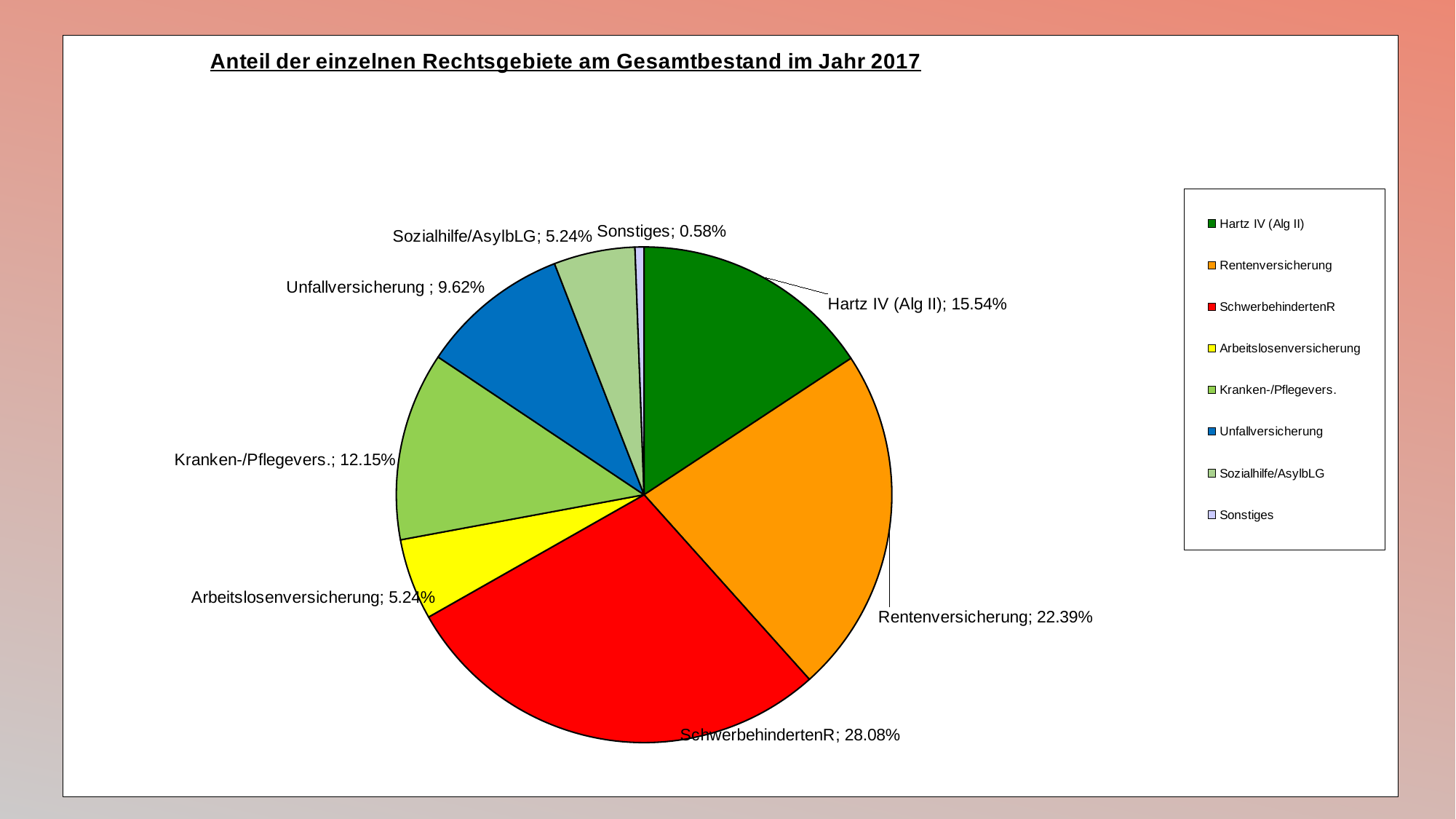
What is the title of the chart? Anteil der einzelnen Rechtsgebiete am Gesamtbestand im Jahr 2017 Which category has the largest slice of the pie? SchwerbehindertenR Which category has the smallest slice of the pie? Sonstiges How many categories are shown in the pie chart? 8 What is the value shown for Sonstiges? 0.58% What share does SchwerbehindertenR have in the pie? 28.08% What is the value shown for Unfallversicherung? 9.62% What kind of chart is shown on the slide? pie chart Which is larger, the share for Hartz IV (Alg II) or the share for Kranken-/Pflegevers.? Hartz IV (Alg II) What is the value shown for Rentenversicherung? 22.39% What is the difference between the shares of SchwerbehindertenR and Rentenversicherung? 5.69% How many entries does the legend list? 8